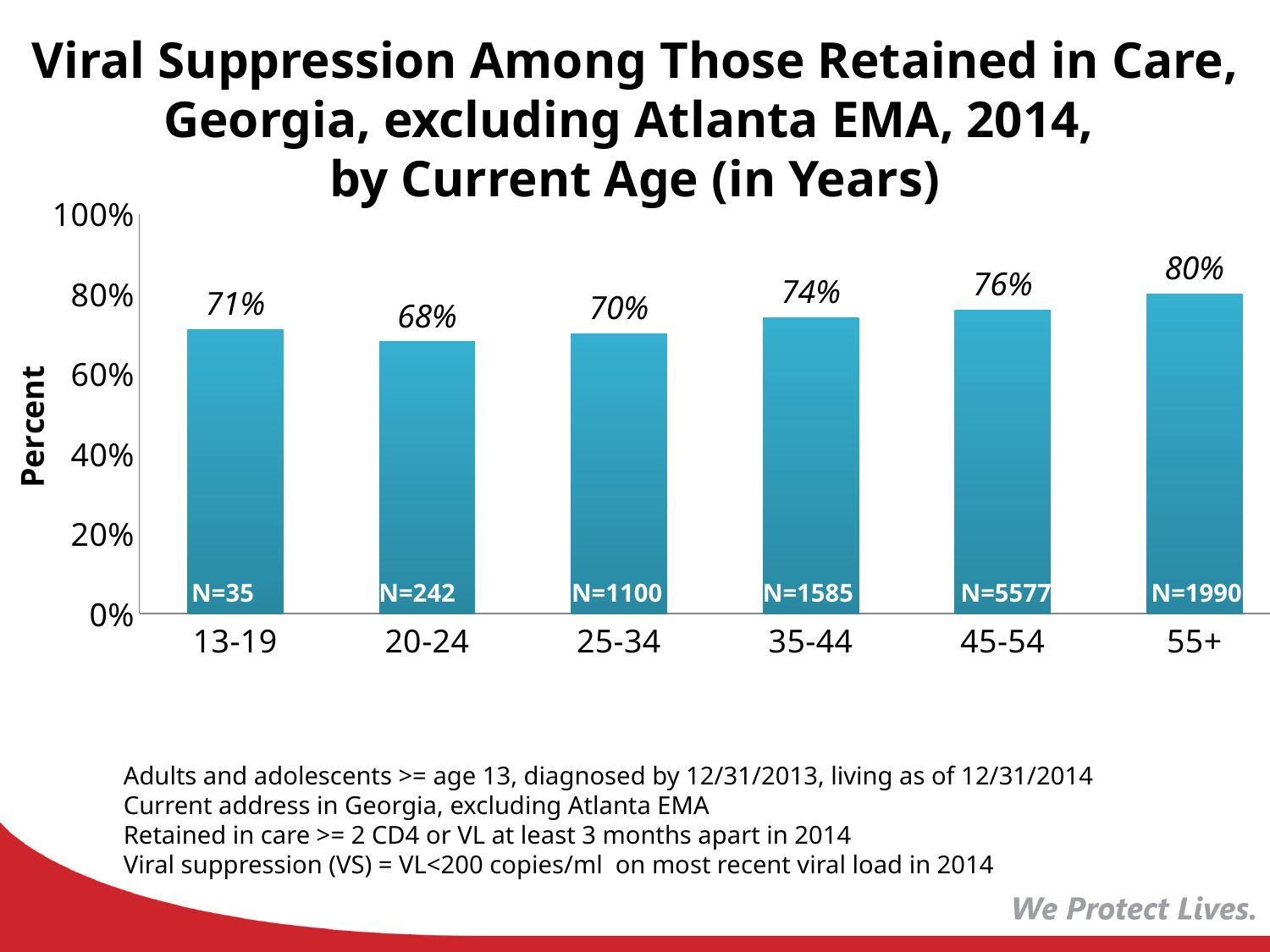
What is the viral suppression percentage for the 13-19 age group? 71% Is the viral suppression value for the 55+ age group greater or less than 60%? greater What kind of chart is shown on the slide? Bar chart What is the difference in viral suppression percentage between the 55+ and 20-24 age groups? 12% Which age group has the highest viral suppression percentage? 55+ How many age groups are shown on the chart? 6 From the 20-24 age group to the 55+ age group, do the viral suppression percentages rise or fall? Rise Which age group has a higher viral suppression percentage, 35-44 or 25-34? 35-44 What is the label on the y axis of the chart? Percent What is the N value shown for the 25-34 age group? N=1100 Which age group has the lowest viral suppression percentage? 20-24 What is the viral suppression percentage for the 45-54 age group? 76%